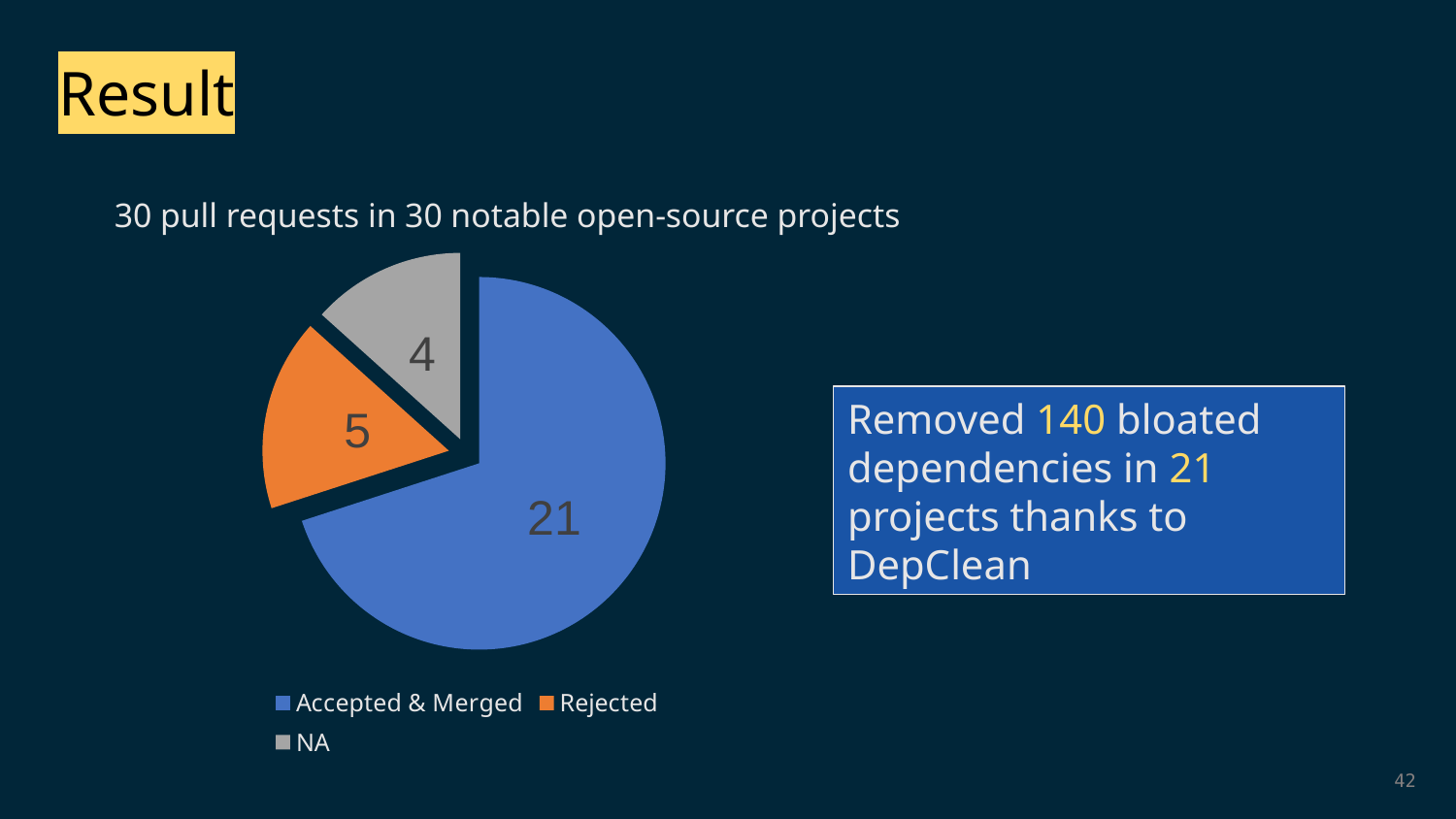
How many entries does the legend list? 3 What is the difference between the Accepted & Merged and Rejected values? 16 How many slices does the pie chart have? 3 What is the value of the NA slice? 4 How many pull requests were Rejected? 5 What share of the pie does the Accepted & Merged slice represent? 70% Which category has the smallest slice of the pie? NA What kind of chart is shown on the slide? pie chart How many pull requests were Accepted & Merged? 21 What colour is the Rejected slice? orange Which category has the largest slice of the pie? Accepted & Merged Which is larger, the Rejected slice or the NA slice? Rejected